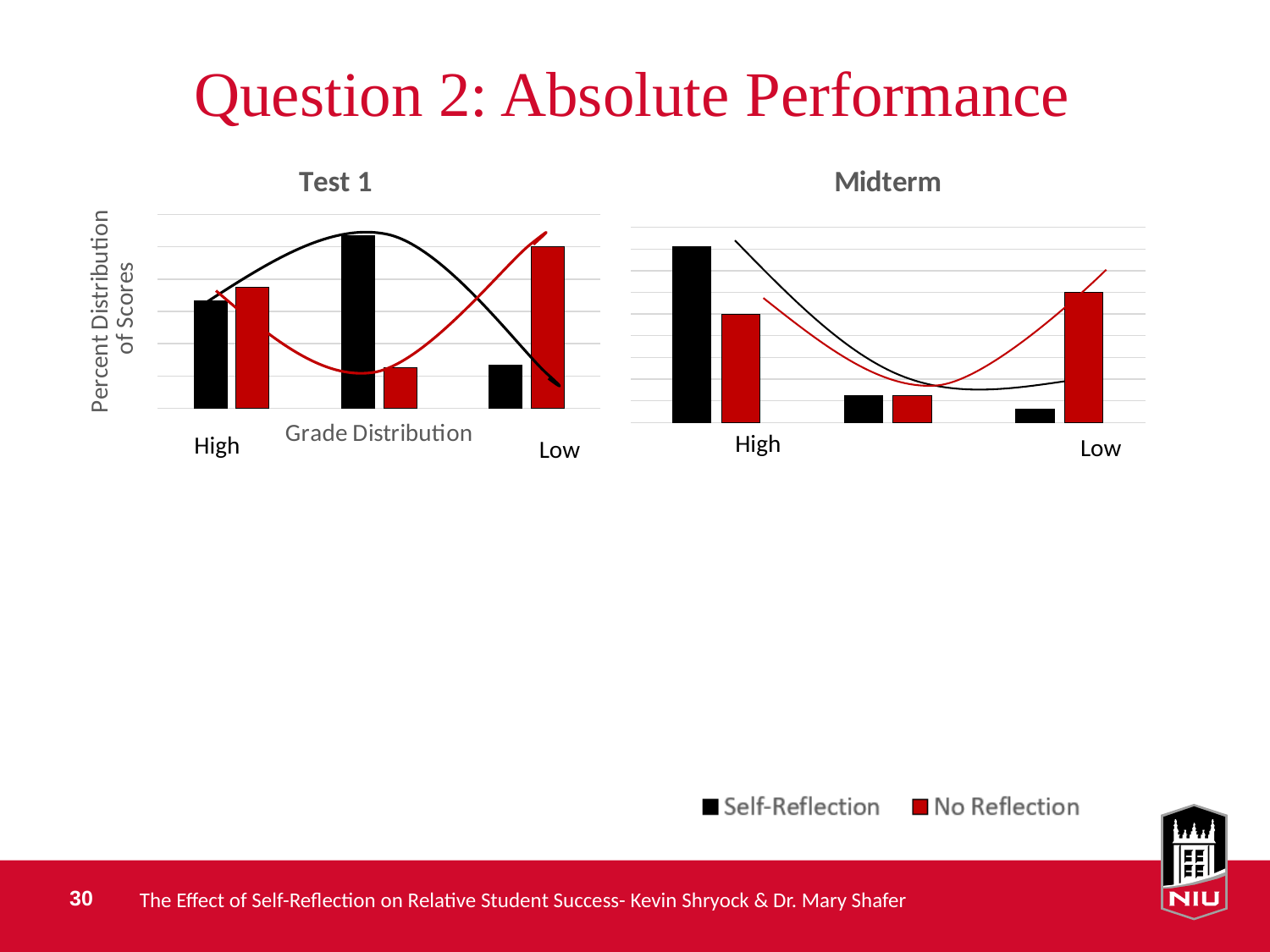
How many series does the legend list? 2 In the Test 1 chart, which category has the highest No Reflection value? Low In the Midterm chart, do the Self-Reflection values rise or fall from High to Low? fall Which colour represents the No Reflection series? red In the Midterm chart, which category has the highest Self-Reflection value? High In the Midterm chart, for the High category, which series has the larger value: Self-Reflection or No Reflection? Self-Reflection What is the y-axis title of the Test 1 chart? Percent Distribution of Scores In the Test 1 chart, which category has the lowest Self-Reflection value? Low How many categories are plotted on the x axis of the Midterm chart? 3 In the Midterm chart, which category has the lowest Self-Reflection value? Low What kind of chart is the Test 1 chart? bar chart In the Test 1 chart, for the Low category, which series has the larger value: Self-Reflection or No Reflection? No Reflection